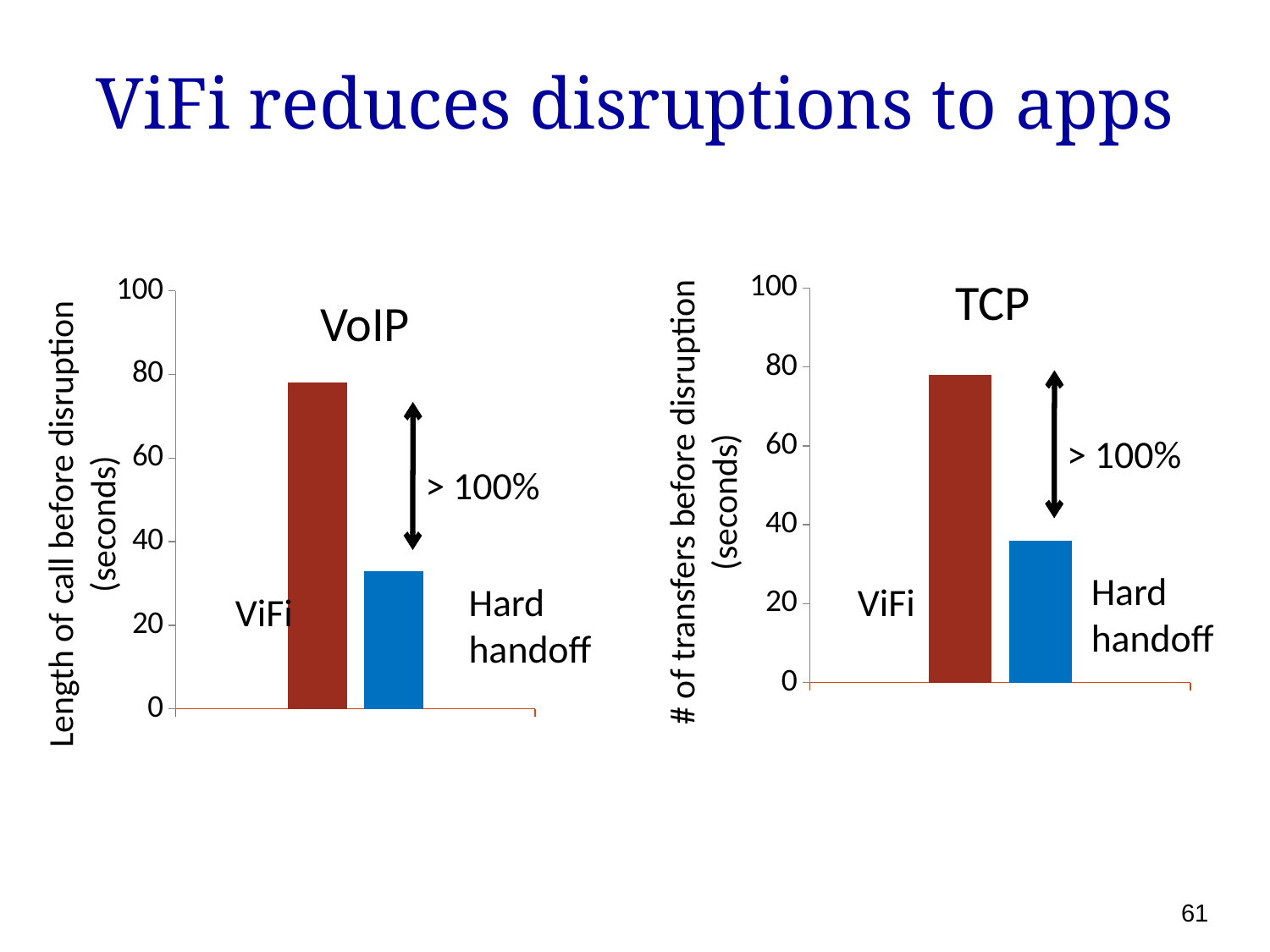
On the TCP chart, is the value for Hard handoff greater or less than 20? greater On the TCP chart, which bar is lower, ViFi or Hard handoff? Hard handoff On the VoIP chart, which bar is higher, ViFi or Hard handoff? ViFi On the VoIP chart, is the value for Hard handoff greater or less than 40? less What is the y-axis label of the VoIP chart? Length of call before disruption (seconds) On the TCP chart, is the value for ViFi greater or less than 60? greater What is the y-axis label of the TCP chart? # of transfers before disruption (seconds) What kind of chart is the VoIP chart? bar chart How many bars does the TCP chart show? 2 On the VoIP chart, which bar is highest? ViFi